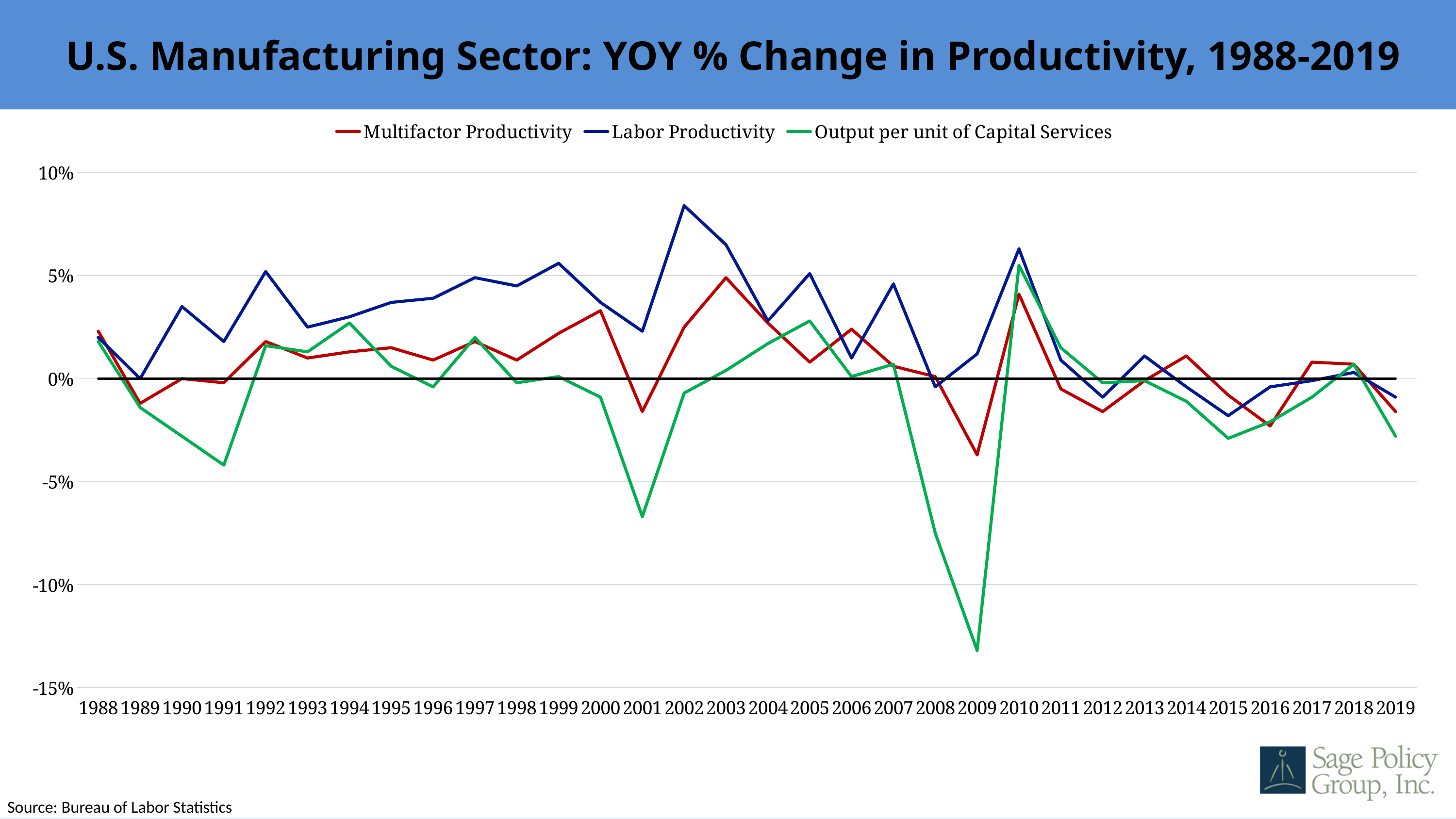
Does Labor Productivity rise or fall from 2002 to 2004? fall Is the value for Output per unit of Capital Services in 2001 greater or less than -5%? less Is the value for Labor Productivity in 2002 greater or less than 5%? greater In 2009, which series is higher: Labor Productivity or Multifactor Productivity? Labor Productivity In which year does Labor Productivity reach its highest value? 2002 Is the value for Output per unit of Capital Services in 2009 greater or less than -10%? less What kind of chart is shown on the slide? line chart How many years are plotted along the x axis? 32 What is the source cited at the bottom of the slide? Bureau of Labor Statistics In which year does Output per unit of Capital Services reach its lowest value? 2009 How many series does the legend list? 3